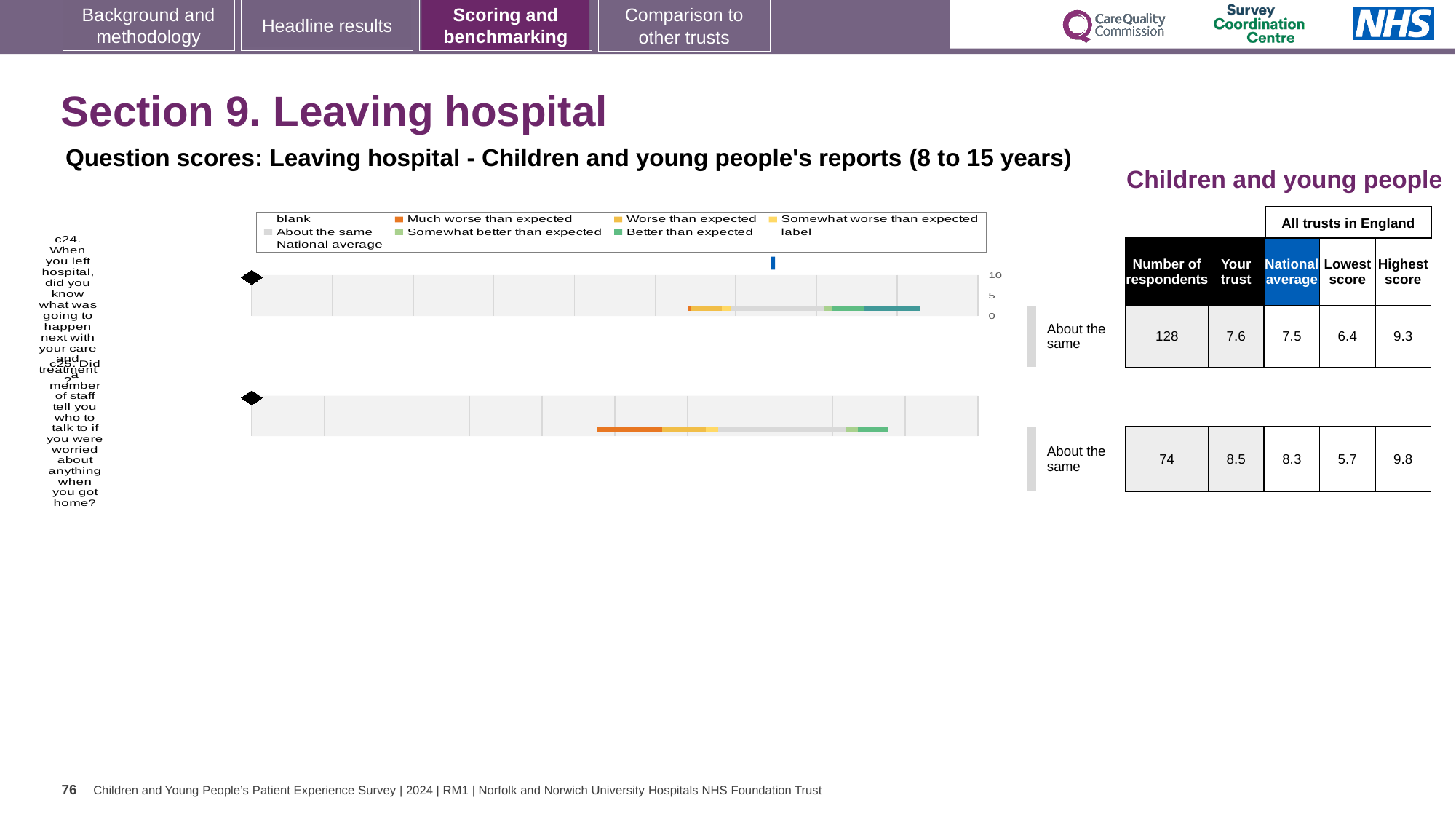
What is the lowest score among all trusts in England for question c24? 6.4 Which question has the higher 'Your trust' score, c24 or c25? c25 What benchmark category is shown for both c24 and c25 in the Leaving hospital chart? About the same How many questions are plotted in the Leaving hospital chart? 2 How many respondents answered question c25 (Did a member of staff tell you who to talk to if you were worried about anything when you got home?)? 74 What is the difference between the highest and lowest scores for question c24? 2.9 What is the 'Your trust' score for question c25? 8.5 What is the 'Your trust' score for question c24 (When you left hospital, did you know what was going to happen next with your care and treatment?)? 7.6 What is the difference between the 'Your trust' score and the national average for question c25? 0.2 What is the highest score among all trusts in England for question c25? 9.8 What type of chart is used to show the question scores for Leaving hospital? bar chart What is the national average score for question c24? 7.5